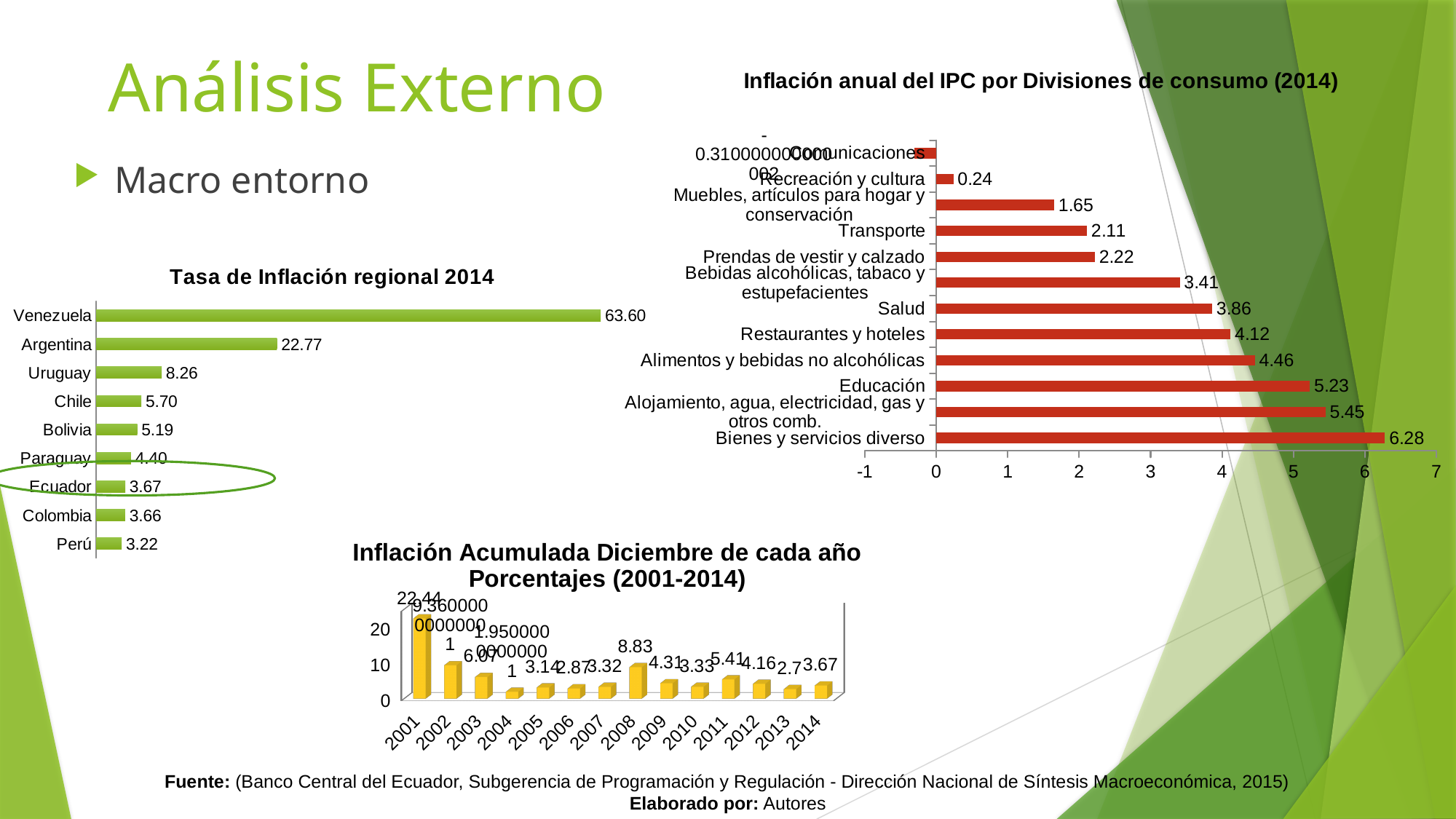
In the 'Tasa de Inflación regional 2014' chart, which country has the lowest inflation rate? Perú In the 'Tasa de Inflación regional 2014' chart, how many countries are shown? 9 In the 'Tasa de Inflación regional 2014' chart, which is larger, Chile or Bolivia? Chile In the 'Inflación Acumulada Diciembre de cada año' chart, what is the value for 2008? 8.83 In the 'Inflación anual del IPC por Divisiones de consumo (2014)' chart, what is the value for Salud? 3.86 In the 'Inflación Acumulada Diciembre de cada año' chart, which year has the highest value? 2001 In the 'Inflación anual del IPC por Divisiones de consumo (2014)' chart, how many divisions are listed? 12 In the 'Tasa de Inflación regional 2014' chart, what is the value for Venezuela? 63.60 What kind of chart is 'Inflación anual del IPC por Divisiones de consumo (2014)'? Bar chart In the 'Inflación anual del IPC por Divisiones de consumo (2014)' chart, what is the difference between Educación and Transporte? 3.12 In the 'Inflación anual del IPC por Divisiones de consumo (2014)' chart, which division has the highest value? Bienes y servicios diverso In the 'Tasa de Inflación regional 2014' chart, what is the difference between Argentina and Uruguay? 14.51